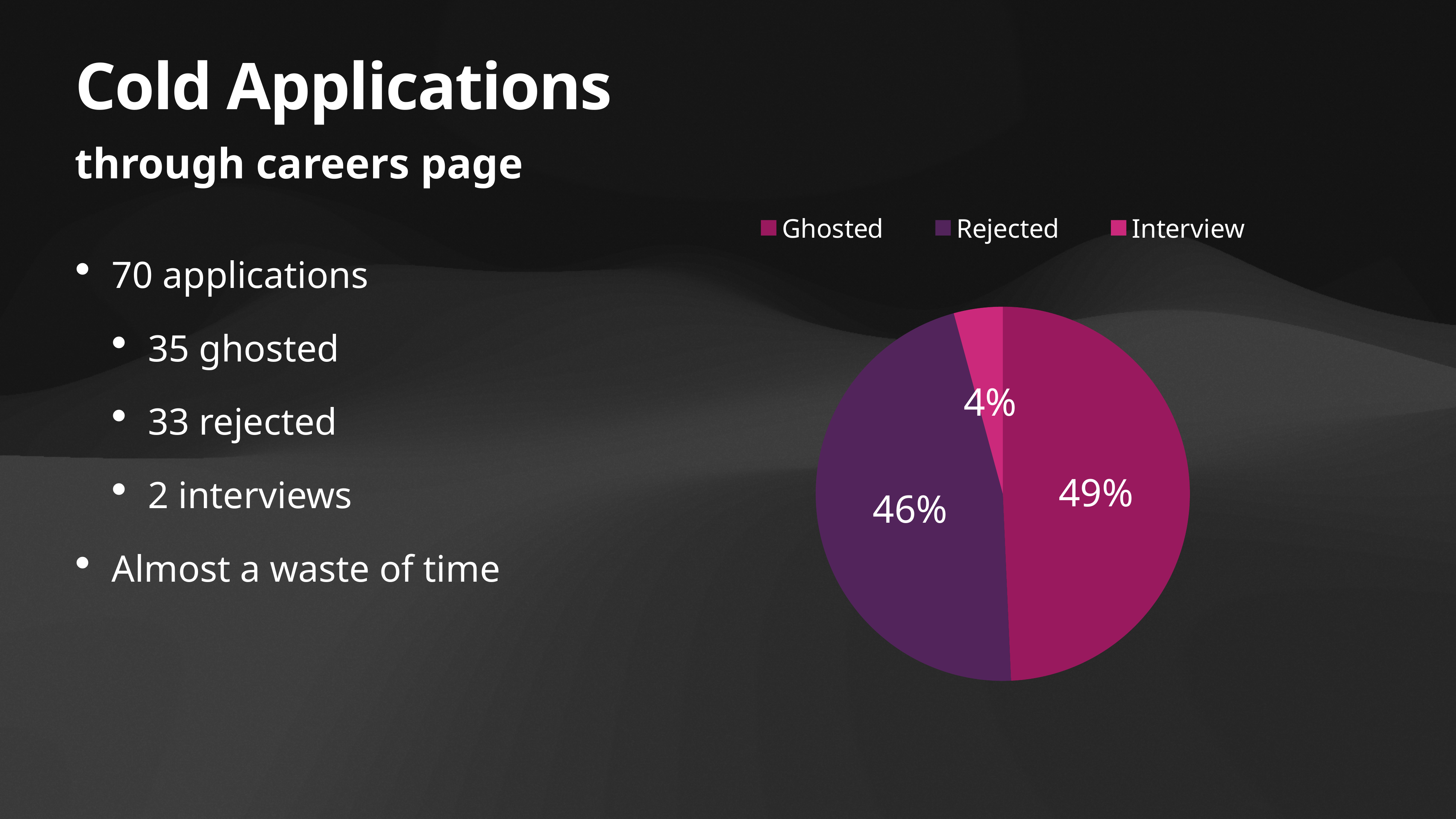
How many slices does the pie chart have? 3 What share of the pie does the Rejected slice represent? 46% Which legend entry is shown in the lightest pink colour? Interview How many entries does the legend list? 3 What share of the pie does the Ghosted slice represent? 49% What share of the pie does the Interview slice represent? 4% What is the difference in percentage points between the Ghosted and Rejected slices? 3% What is the difference in percentage points between the Rejected and Interview slices? 42% Which category has the smallest slice of the pie? Interview Which slice is larger, Rejected or Interview? Rejected What kind of chart is shown on the slide? pie chart Which category has the largest slice of the pie? Ghosted